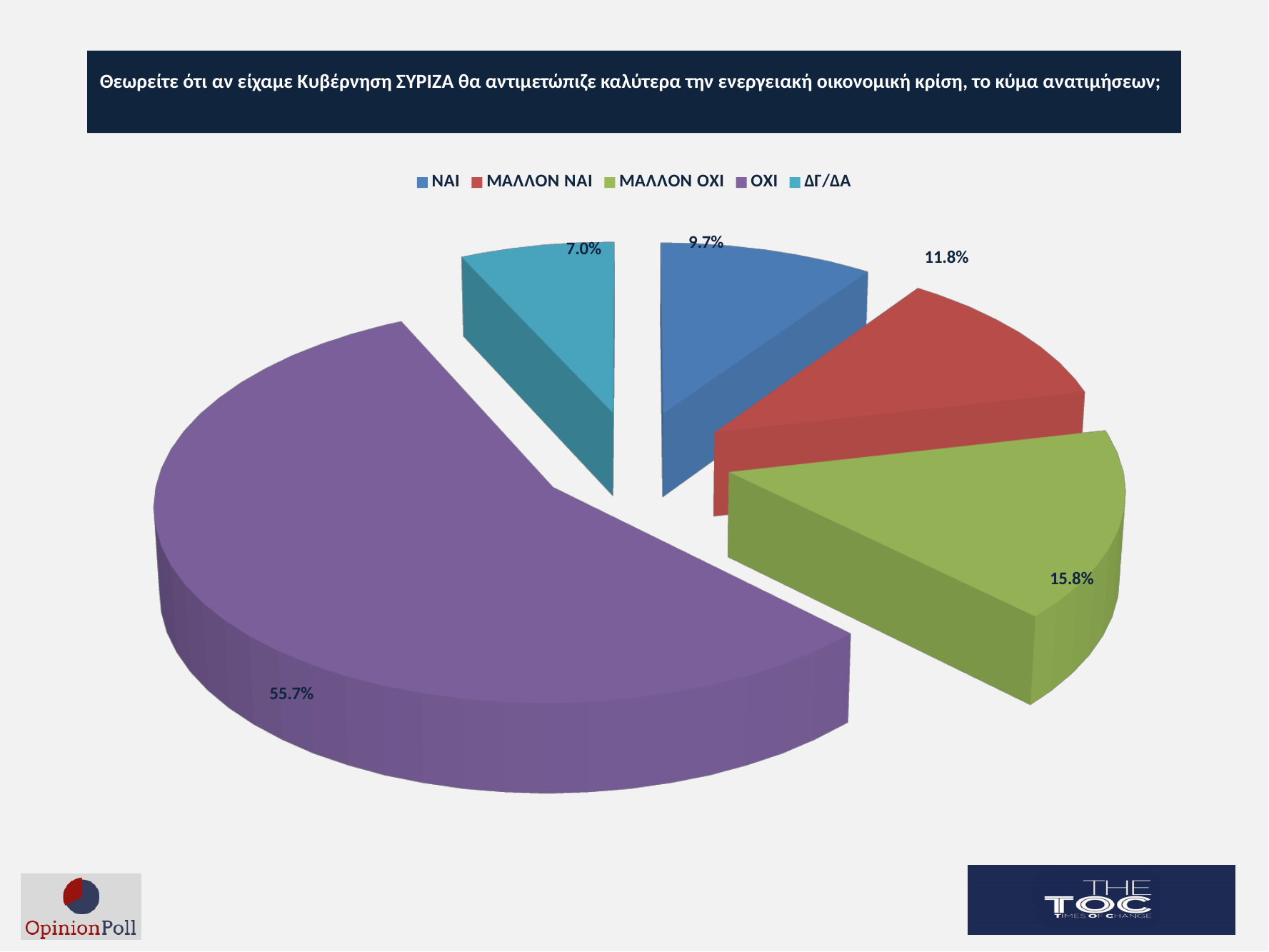
What is the difference in percentage points between ΟΧΙ and ΜΑΛΛΟΝ ΟΧΙ? 39.9 What percentage is shown for ΟΧΙ? 55.7% Which category has the smallest slice of the pie? ΔΓ/ΔΑ What is the combined percentage of ΝΑΙ and ΜΑΛΛΟΝ ΝΑΙ? 21.5% Which is larger, ΜΑΛΛΟΝ ΝΑΙ or ΝΑΙ? ΜΑΛΛΟΝ ΝΑΙ Which colour represents ΟΧΙ in the pie chart? Purple Which category has the largest slice of the pie? ΟΧΙ How many slices does the pie chart have? 5 What percentage is shown for ΜΑΛΛΟΝ ΟΧΙ? 15.8% What percentage is shown for ΝΑΙ? 9.7% What percentage is shown for ΔΓ/ΔΑ? 7.0% What type of chart is shown on the slide? Pie chart